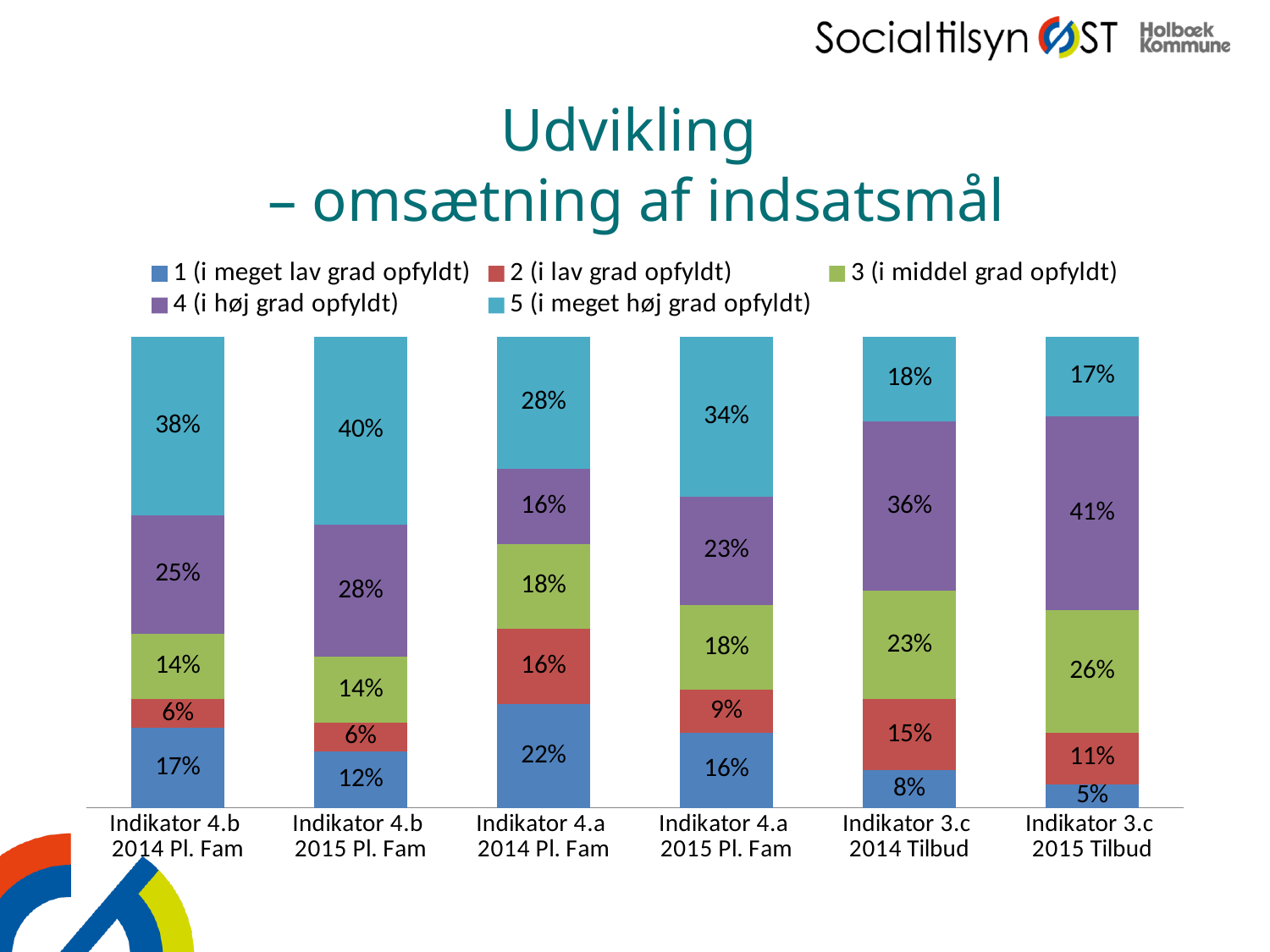
What is the value for "4 (i høj grad opfyldt)" in Indikator 4.a 2014 Pl. Fam? 16% How many categories are shown on the x axis? 6 How many series does the legend list? 5 Which category has the highest value for "4 (i høj grad opfyldt)"? Indikator 3.c 2015 Tilbud What is the total of the stacked bar for Indikator 3.c 2014 Tilbud? 100% Which is larger: the "2 (i lav grad opfyldt)" value for Indikator 4.a 2014 Pl. Fam or for Indikator 3.c 2014 Tilbud? Indikator 4.a 2014 Pl. Fam What is the difference between the "5 (i meget høj grad opfyldt)" values for Indikator 4.a 2015 Pl. Fam and Indikator 4.a 2014 Pl. Fam? 6% Which legend entry is shown in purple? 4 (i høj grad opfyldt) What is the value for "5 (i meget høj grad opfyldt)" in Indikator 4.b 2015 Pl. Fam? 40% What is the value for "1 (i meget lav grad opfyldt)" in Indikator 3.c 2015 Tilbud? 5% What kind of chart is shown on the slide? Stacked bar chart Which category has the lowest value for "1 (i meget lav grad opfyldt)"? Indikator 3.c 2015 Tilbud